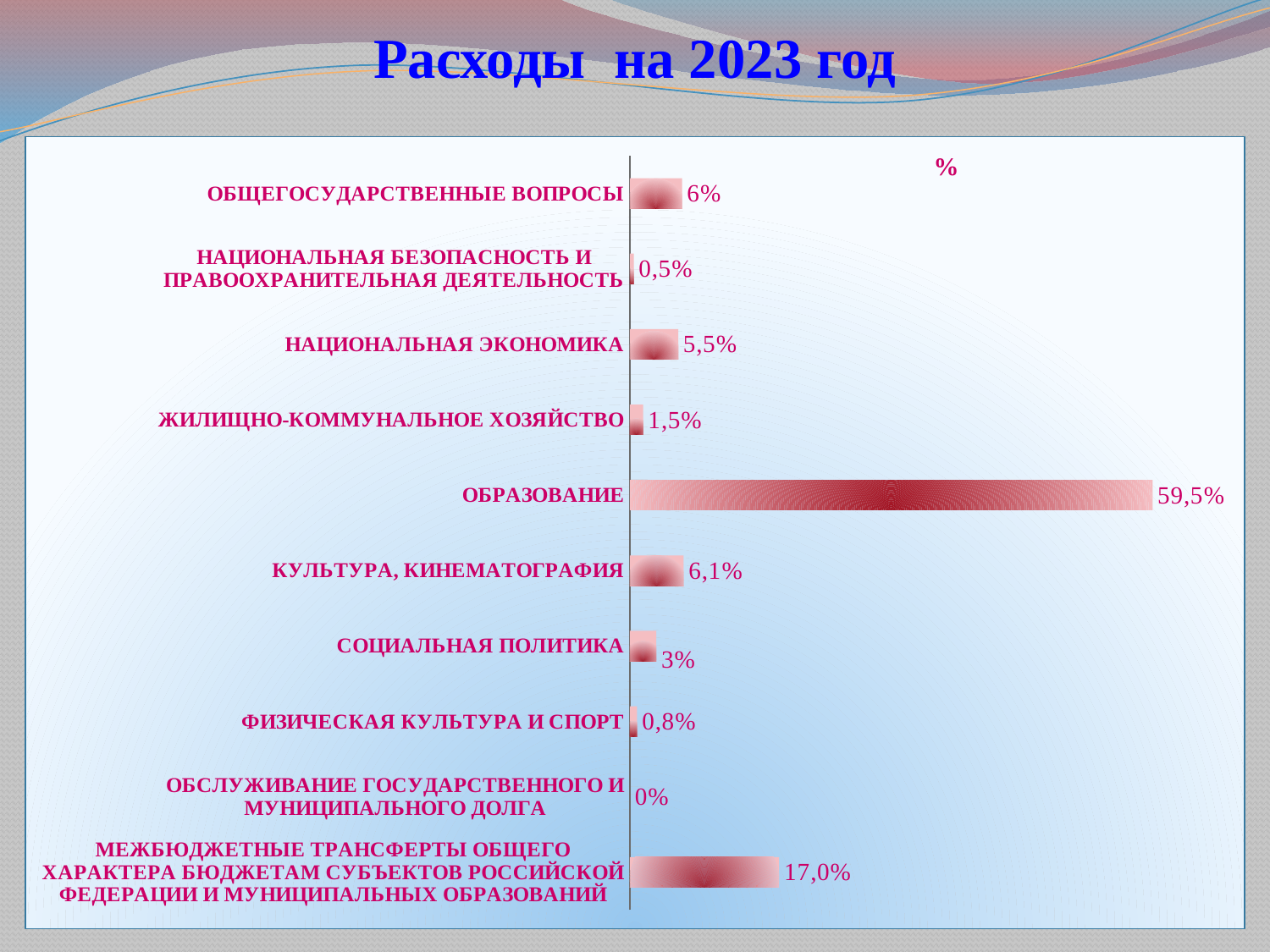
What is the difference between the values for ОБРАЗОВАНИЕ and МЕЖБЮДЖЕТНЫЕ ТРАНСФЕРТЫ ОБЩЕГО ХАРАКТЕРА БЮДЖЕТАМ СУБЪЕКТОВ РОССИЙСКОЙ ФЕДЕРАЦИИ И МУНИЦИПАЛЬНЫХ ОБРАЗОВАНИЙ? 42,5% What is the value for МЕЖБЮДЖЕТНЫЕ ТРАНСФЕРТЫ ОБЩЕГО ХАРАКТЕРА БЮДЖЕТАМ СУБЪЕКТОВ РОССИЙСКОЙ ФЕДЕРАЦИИ И МУНИЦИПАЛЬНЫХ ОБРАЗОВАНИЙ? 17,0% Which category has the highest value? ОБРАЗОВАНИЕ Which is larger: the value for КУЛЬТУРА, КИНЕМАТОГРАФИЯ or the value for СОЦИАЛЬНАЯ ПОЛИТИКА? КУЛЬТУРА, КИНЕМАТОГРАФИЯ How many categories are shown in the chart? 10 Which category has the lowest value? ОБСЛУЖИВАНИЕ ГОСУДАРСТВЕННОГО И МУНИЦИПАЛЬНОГО ДОЛГА Which is larger: the value for ЖИЛИЩНО-КОММУНАЛЬНОЕ ХОЗЯЙСТВО or the value for НАЦИОНАЛЬНАЯ БЕЗОПАСНОСТЬ И ПРАВООХРАНИТЕЛЬНАЯ ДЕЯТЕЛЬНОСТЬ? ЖИЛИЩНО-КОММУНАЛЬНОЕ ХОЗЯЙСТВО What is the title of the slide? Расходы на 2023 год What is the value for ФИЗИЧЕСКАЯ КУЛЬТУРА И СПОРТ? 0,8% What is the value for ОБРАЗОВАНИЕ? 59,5% What kind of chart is shown on the slide? bar chart What is the value for НАЦИОНАЛЬНАЯ ЭКОНОМИКА? 5,5%